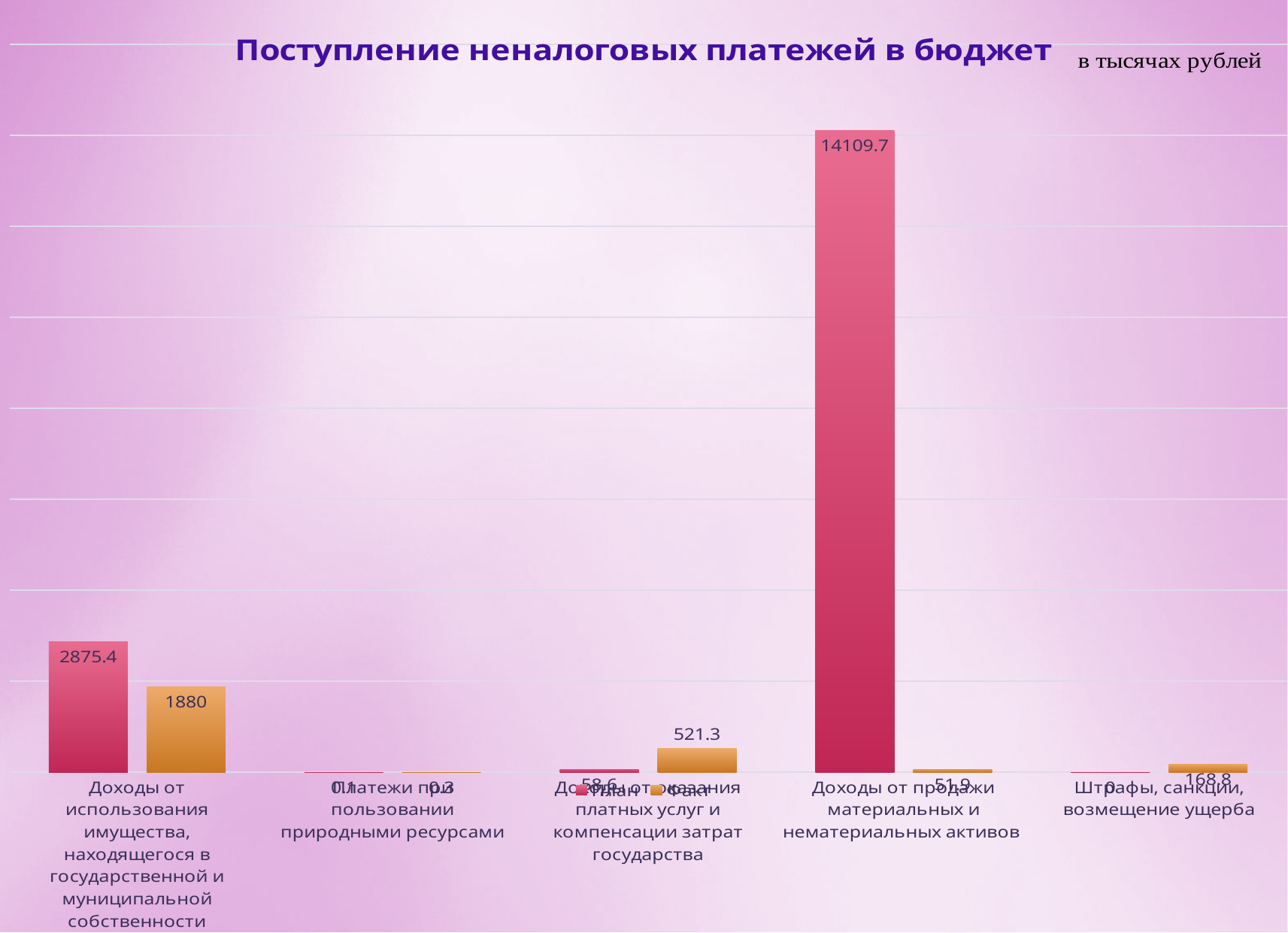
Which category has the highest План value? Доходы от продажи материальных и нематериальных активов What is the difference between the План and Факт values for 'Доходы от использования имущества, находящегося в государственной и муниципальной собственности'? 995.4 What is the Факт value for 'Штрафы, санкции, возмещение ущерба'? 168.8 What is the Факт value for 'Доходы от использования имущества, находящегося в государственной и муниципальной собственности'? 1880 How many series does the legend list? 2 What is the Факт value for 'Доходы от оказания платных услуг и компенсации затрат государства'? 521.3 What is the title of the chart? Поступление неналоговых платежей в бюджет How many categories are shown on the x axis? 5 What type of chart is shown on the slide? bar chart Which category has the highest Факт value? Доходы от использования имущества, находящегося в государственной и муниципальной собственности What is the План value for 'Доходы от продажи материальных и нематериальных активов'? 14109.7 For 'Доходы от продажи материальных и нематериальных активов', which is larger: План or Факт? План